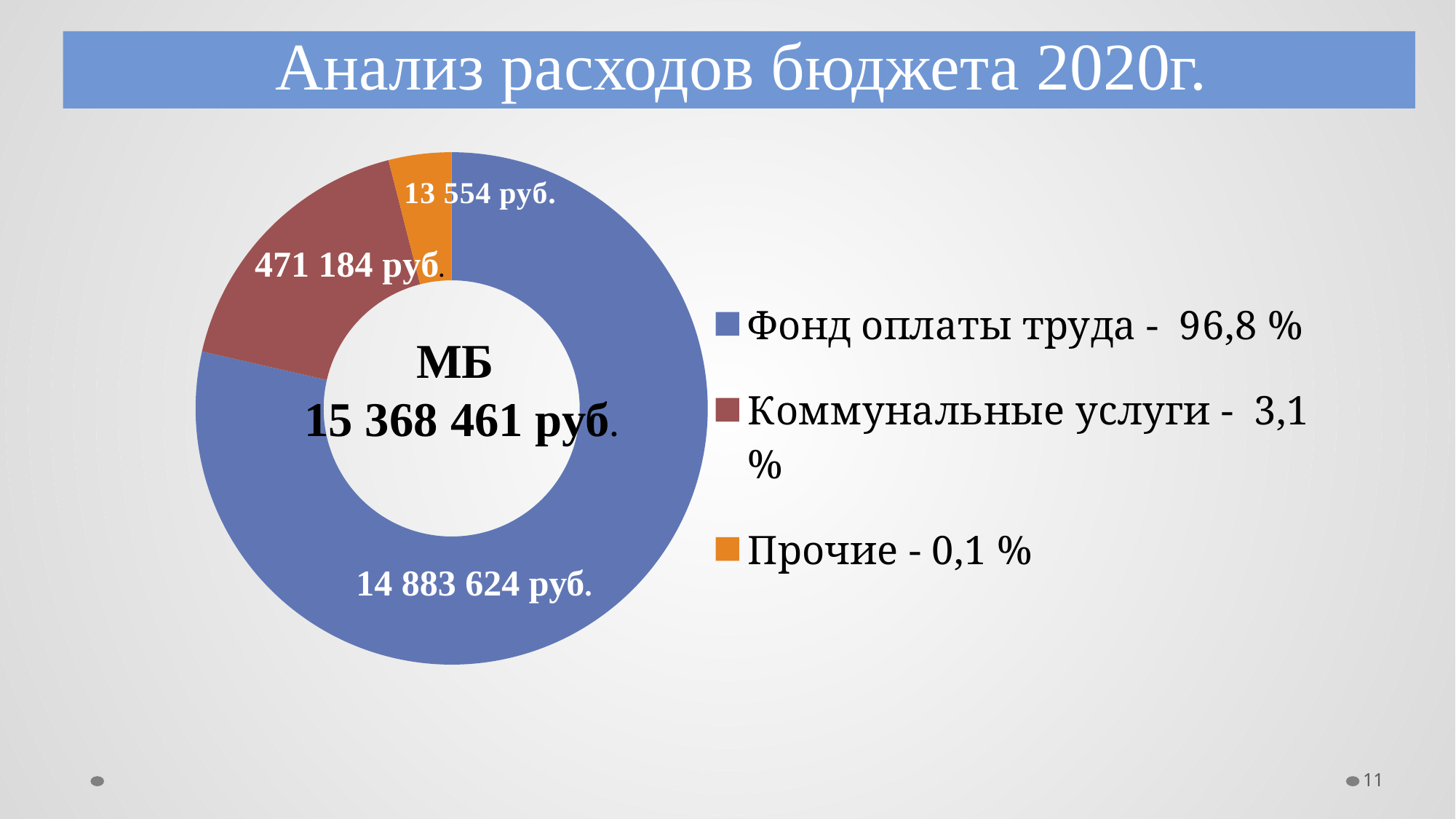
Which category has the smallest share of the chart? Прочие What kind of chart is shown on the slide? Doughnut (pie) chart Which is larger, the value for Коммунальные услуги or the value for Прочие? Коммунальные услуги What share of the budget does Коммунальные услуги account for? 3,1 % What is the difference between the values for Коммунальные услуги and Прочие? 457 630 руб. What share of the budget does Прочие account for? 0,1 % How many categories does the legend list? 3 Which category has the largest share of the chart? Фонд оплаты труда What is the value for Прочие? 13 554 руб. What is the value for Фонд оплаты труда? 14 883 624 руб. What share of the budget does Фонд оплаты труда account for? 96,8 % What is the value for Коммунальные услуги? 471 184 руб.